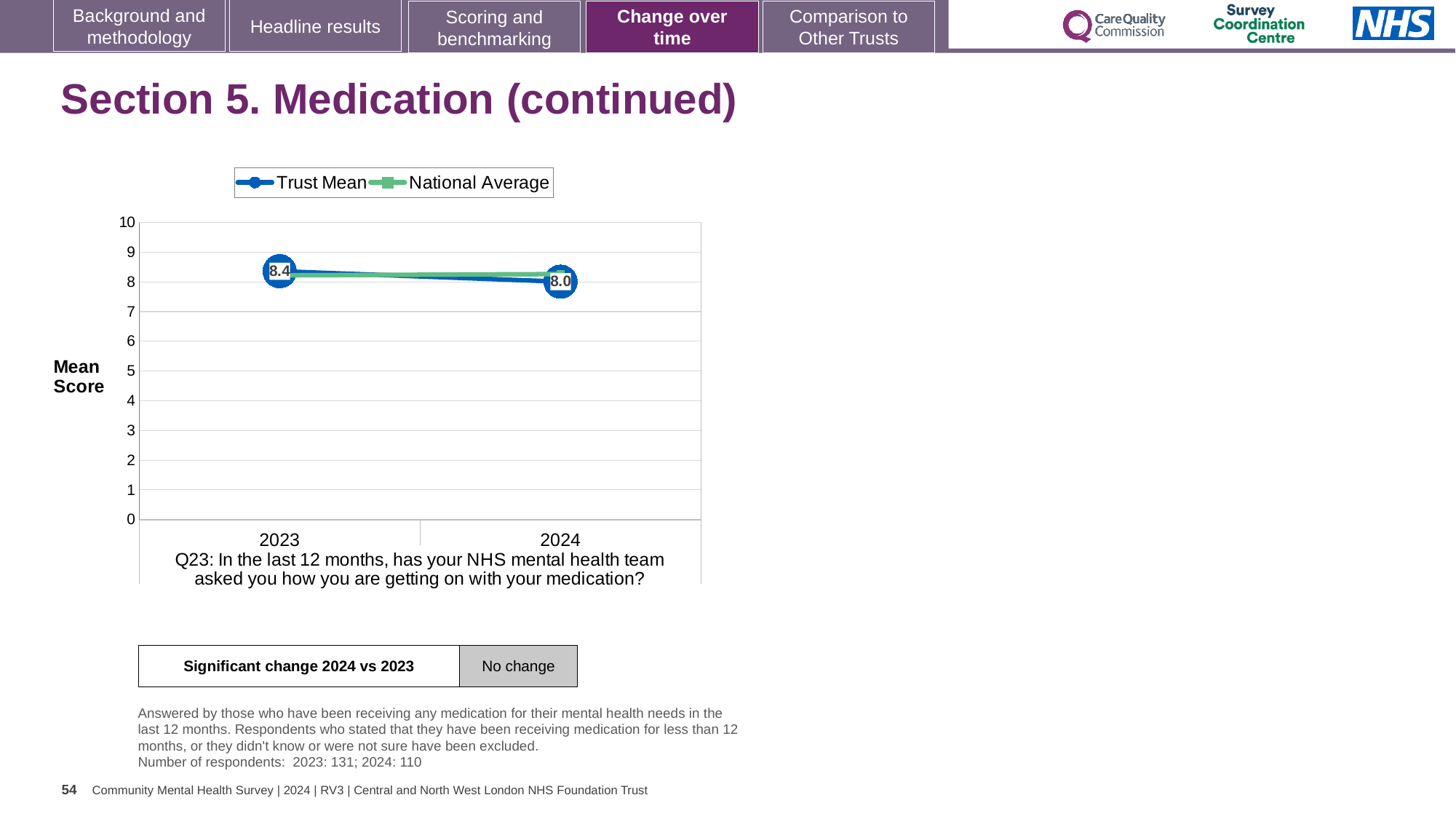
Which year has the higher Trust Mean, 2023 or 2024? 2023 In which year is the Trust Mean at its lowest? 2024 How many series does the legend list? 2 What is the Trust Mean value for 2023? 8.4 What is the label on the y axis of the chart? Mean Score Is the National Average value for 2023 greater or less than 7? greater What is the Trust Mean value for 2024? 8.0 What kind of chart is shown on the slide? line chart Does the Trust Mean rise or fall from 2023 to 2024? fall In which year is the Trust Mean at its highest? 2023 By how much did the Trust Mean change from 2023 to 2024? 0.4 How many years are plotted on the x axis? 2